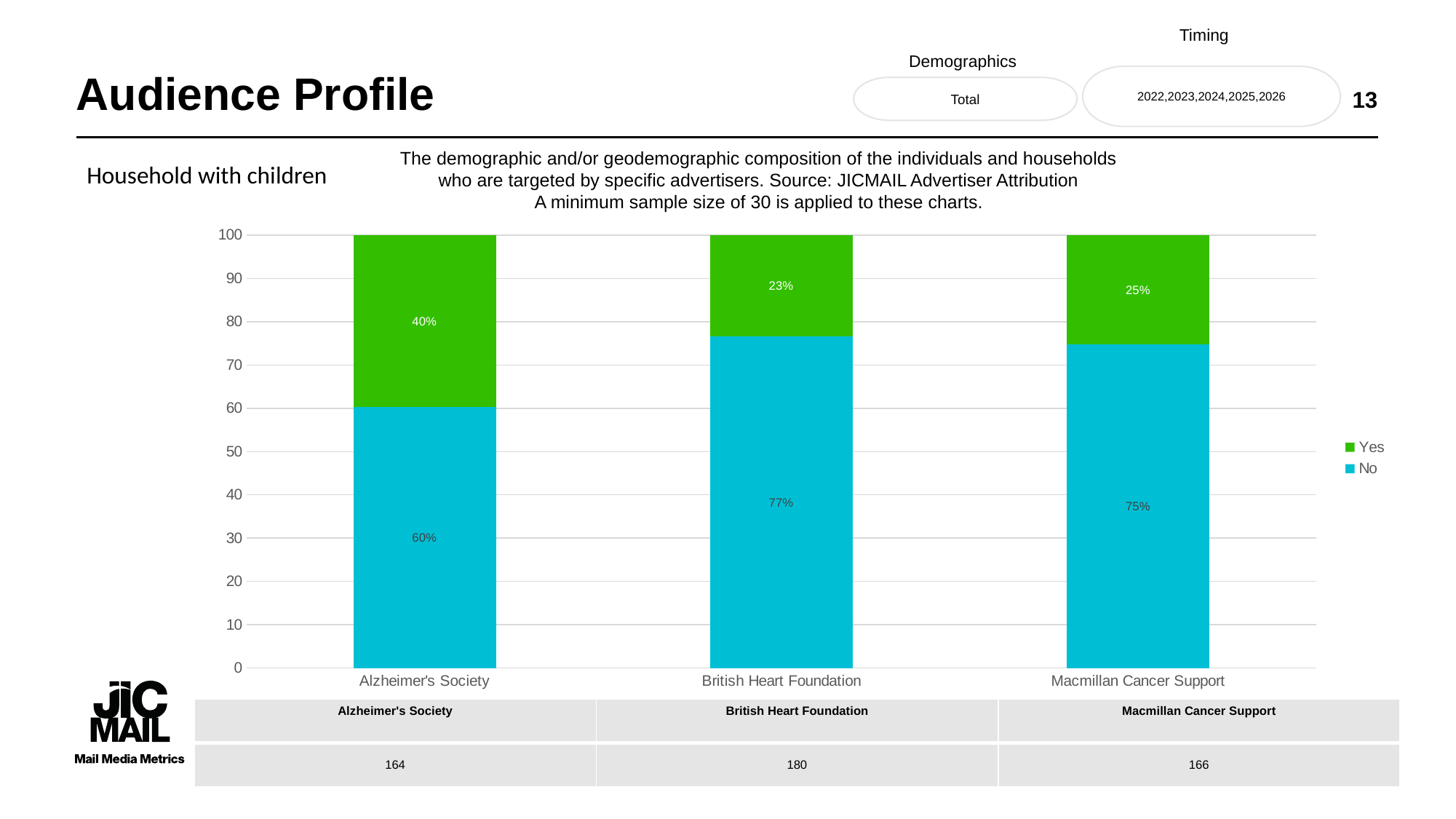
What is the 'No' value for British Heart Foundation? 77% How many advertisers are shown on the x axis? 3 Which advertiser has the lowest 'Yes' share? British Heart Foundation Is the 'Yes' value larger for Alzheimer's Society or for Macmillan Cancer Support? Alzheimer's Society What kind of chart is shown? Stacked bar chart What is the 'Yes' value for Alzheimer's Society? 40% How many series does the legend list? 2 What is the 'No' value for Macmillan Cancer Support? 75% Which advertiser has the highest 'Yes' share? Alzheimer's Society Which colour represents the 'No' series? Blue What is the difference between the 'No' values for British Heart Foundation and Alzheimer's Society? 17% What is the 'Yes' value for Macmillan Cancer Support? 25%